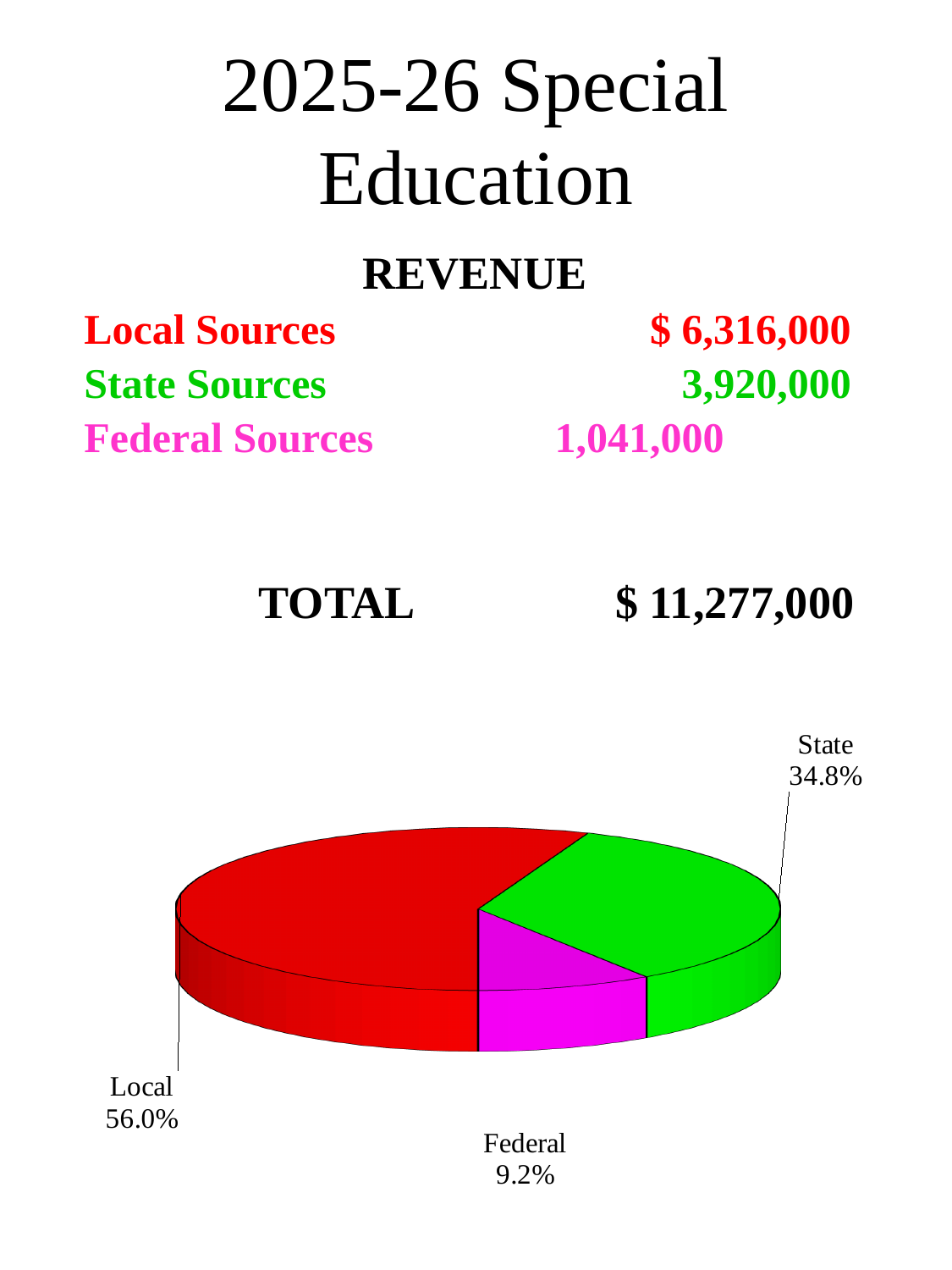
What is the difference in percentage points between the Local and State slices? 21.2 What share of the pie does the State slice represent? 34.8% What colour is the Local slice of the pie? red Which slice of the pie is the largest? Local Which is larger, the State slice or the Federal slice? State What kind of chart is shown on the slide? pie chart Which slice of the pie is the smallest? Federal What colour is the Federal slice of the pie? magenta How many slices does the pie chart have? 3 What share of the pie does the Federal slice represent? 9.2% What share of the pie does the Local slice represent? 56.0% What is the difference in percentage points between the State and Federal slices? 25.6